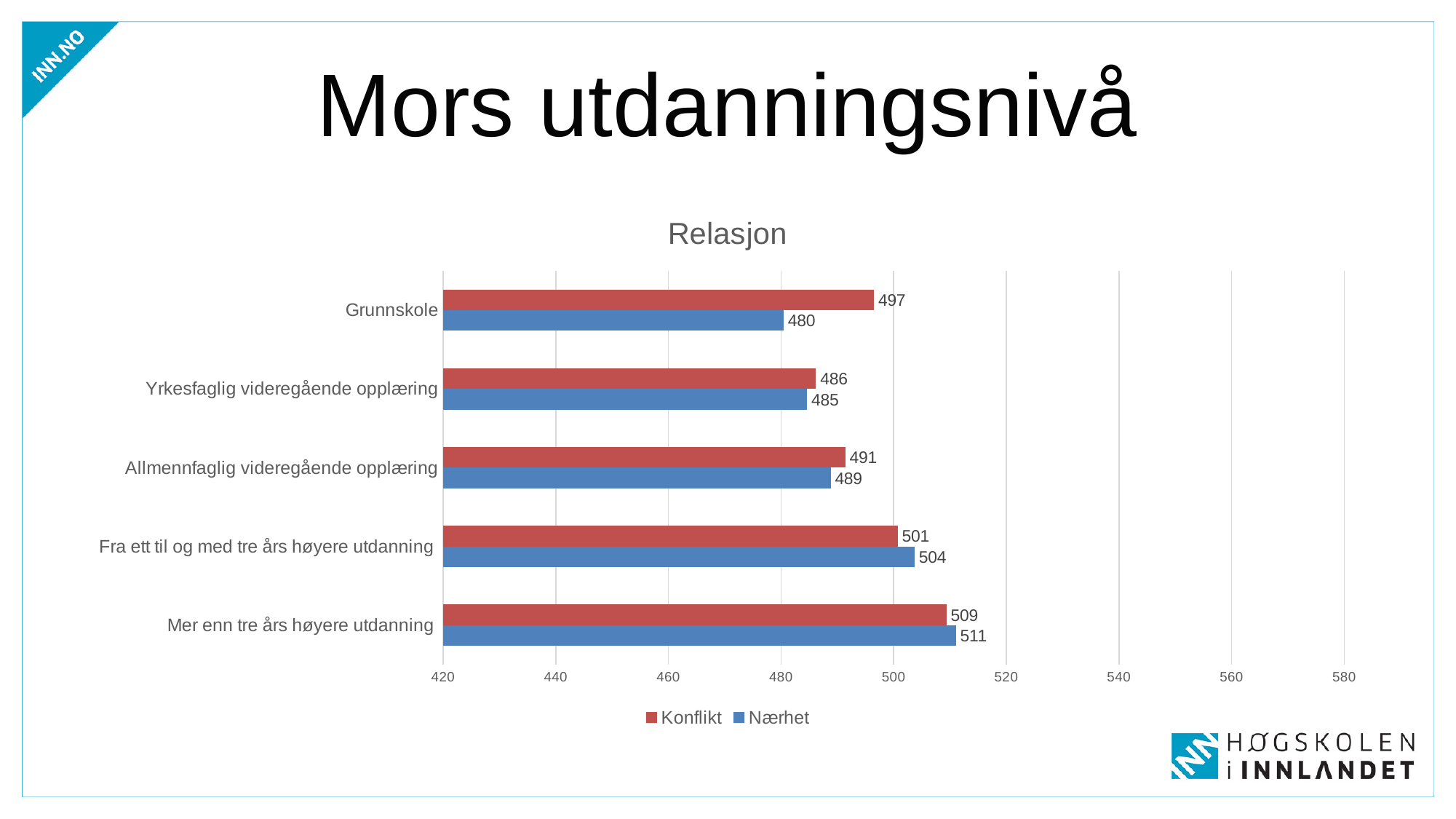
What is the difference between the Konflikt and Nærhet values for Grunnskole? 17 What kind of chart is shown? Bar chart What is the Nærhet value for Fra ett til og med tre års høyere utdanning? 504 Which category has the highest Nærhet value? Mer enn tre års høyere utdanning What is the Nærhet value for Yrkesfaglig videregående opplæring? 485 What is the Konflikt value for Grunnskole? 497 Which is larger for Mer enn tre års høyere utdanning, Konflikt or Nærhet? Nærhet Which category has the lowest Konflikt value? Yrkesfaglig videregående opplæring What is the title of the chart? Relasjon Which category has the lowest Nærhet value? Grunnskole How many categories are shown on the y axis? 5 How many series does the legend list? 2